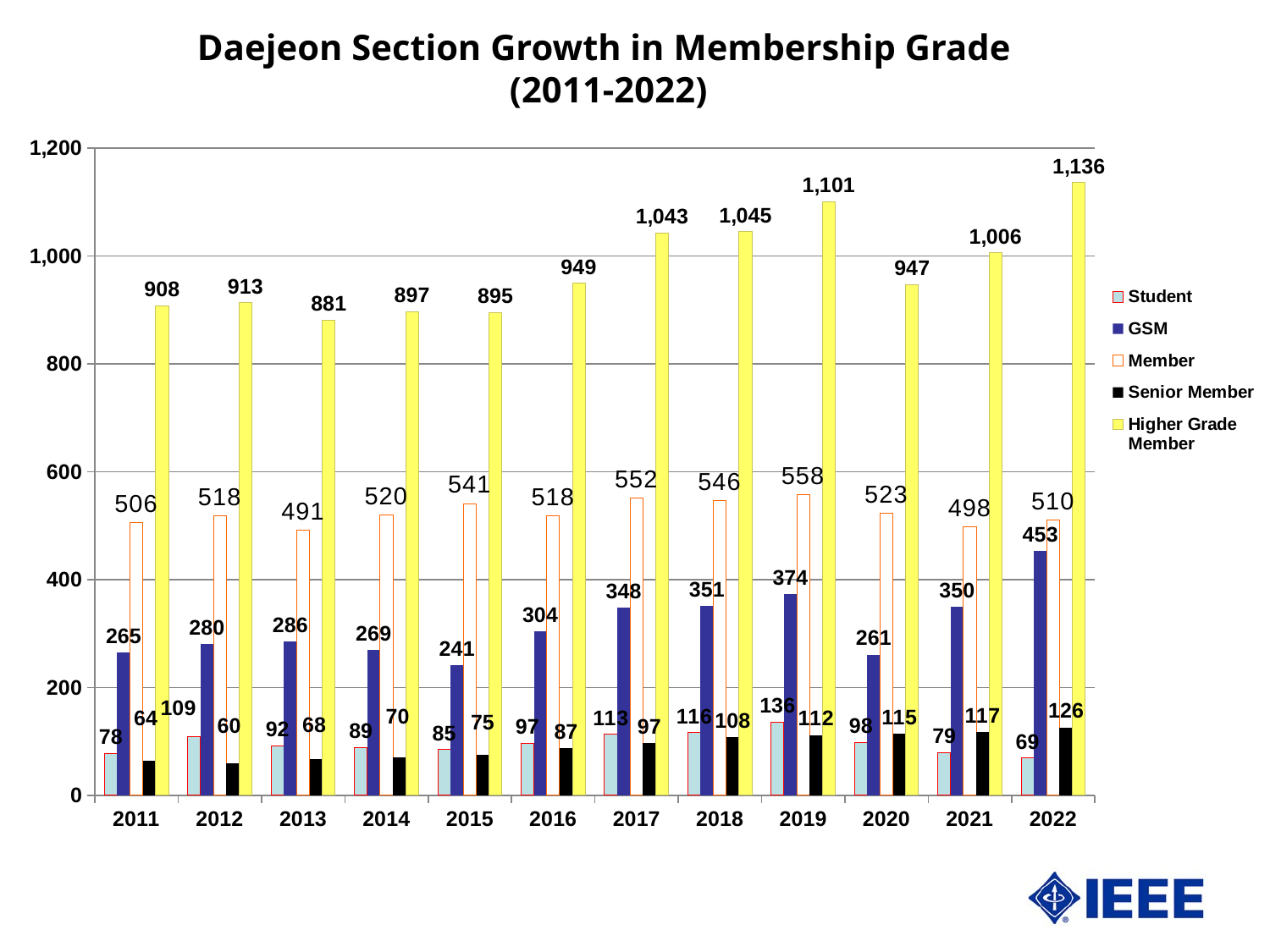
What is the value for Senior Member in 2020? 115 Which is larger, the GSM value in 2022 or the GSM value in 2021? 2022 How many years are shown on the x axis? 12 In which year is the Student series lowest? 2022 What is the difference between the Higher Grade Member values in 2022 and 2011? 228 What is the value for GSM in 2019? 374 What kind of chart is shown on the slide? Bar chart In which year is the Member series highest? 2019 How many series does the legend list? 5 What is the value for Higher Grade Member in 2022? 1,136 What is the value for Student in 2012? 109 Which series is shown in yellow? Higher Grade Member